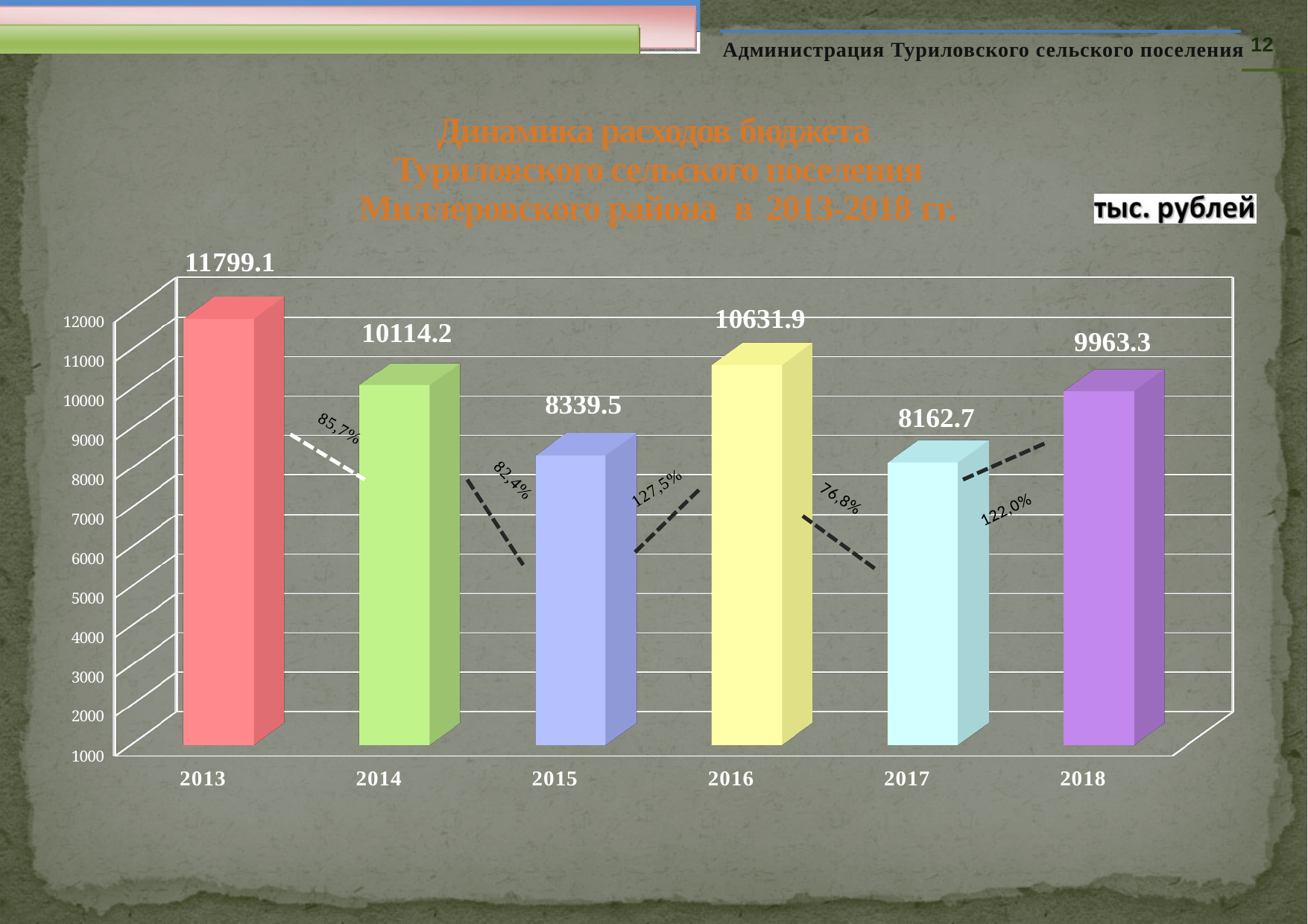
What is the value shown for 2017? 8162.7 Which year has the lowest value? 2017 What is the difference between the values for 2016 and 2015? 2292.4 Which is larger, the value for 2016 or the value for 2018? 2016 What unit of measurement is indicated for the chart? тыс. рублей What is the difference between the values for 2013 and 2014? 1684.9 What is the budget expenditure value shown for 2013? 11799.1 How many years are shown on the x axis? 6 What is the value shown for 2018? 9963.3 What percentage label is shown between the 2015 and 2016 bars? 127,5% Which year has the highest value? 2013 What kind of chart is shown on the slide? bar chart